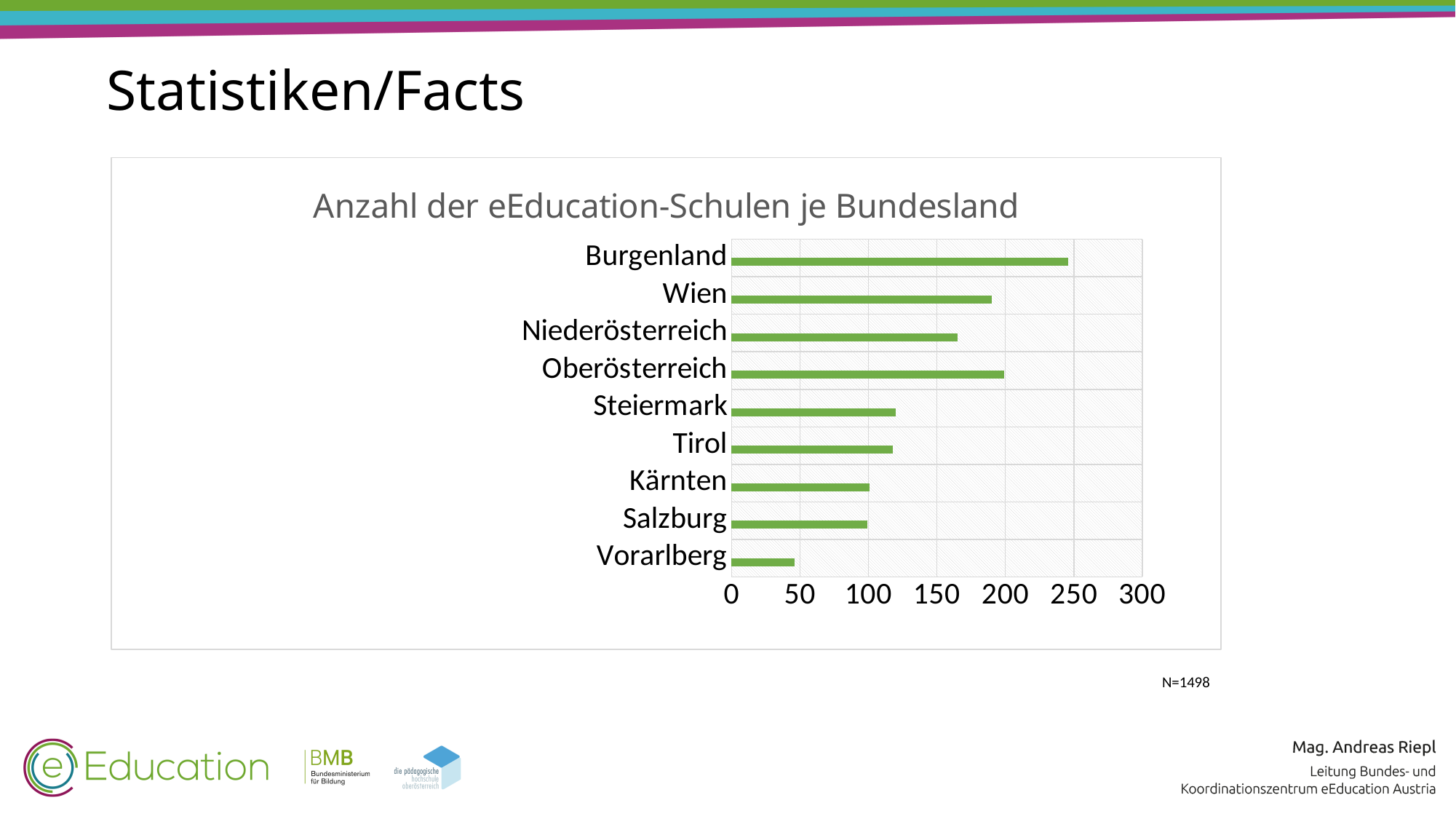
Which has more eEducation-Schulen, Burgenland or Oberösterreich? Burgenland Which has more eEducation-Schulen, Wien or Niederösterreich? Wien Is the value for Burgenland greater or less than 200? greater Which Bundesland has the highest number of eEducation-Schulen? Burgenland Is the value for Niederösterreich greater or less than 150? greater Which Bundesland has the lowest number of eEducation-Schulen? Vorarlberg What kind of chart is shown on the slide? bar chart Is the value for Steiermark greater or less than 100? greater What is the title of the chart? Anzahl der eEducation-Schulen je Bundesland How many Bundesländer (categories) are shown in the chart? 9